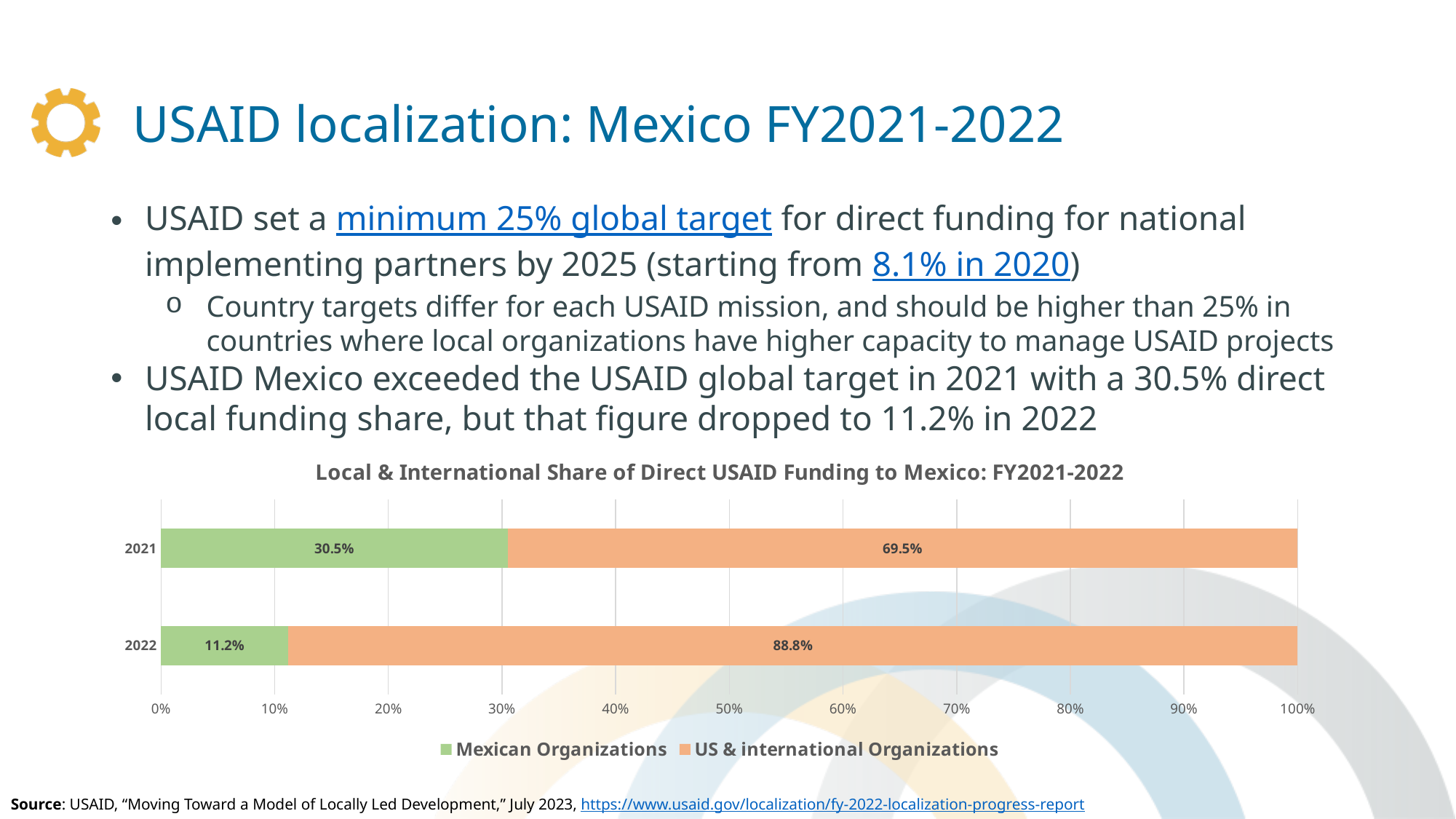
Which is larger in 2022: the Mexican Organizations share or the US & international Organizations share? US & international Organizations How many series does the legend list? 2 What is the value for Mexican Organizations in 2022? 11.2% What is the value for US & international Organizations in 2022? 88.8% What is the total of the stacked bar for 2021? 100% In which year is the Mexican Organizations share higher? 2021 What kind of chart is shown on the slide? Stacked bar chart What is the value for Mexican Organizations in 2021? 30.5% How many years are shown on the chart? 2 What is the value for US & international Organizations in 2021? 69.5% What is the title of the chart? Local & International Share of Direct USAID Funding to Mexico: FY2021-2022 What is the difference between the Mexican Organizations share in 2021 and in 2022? 19.3%